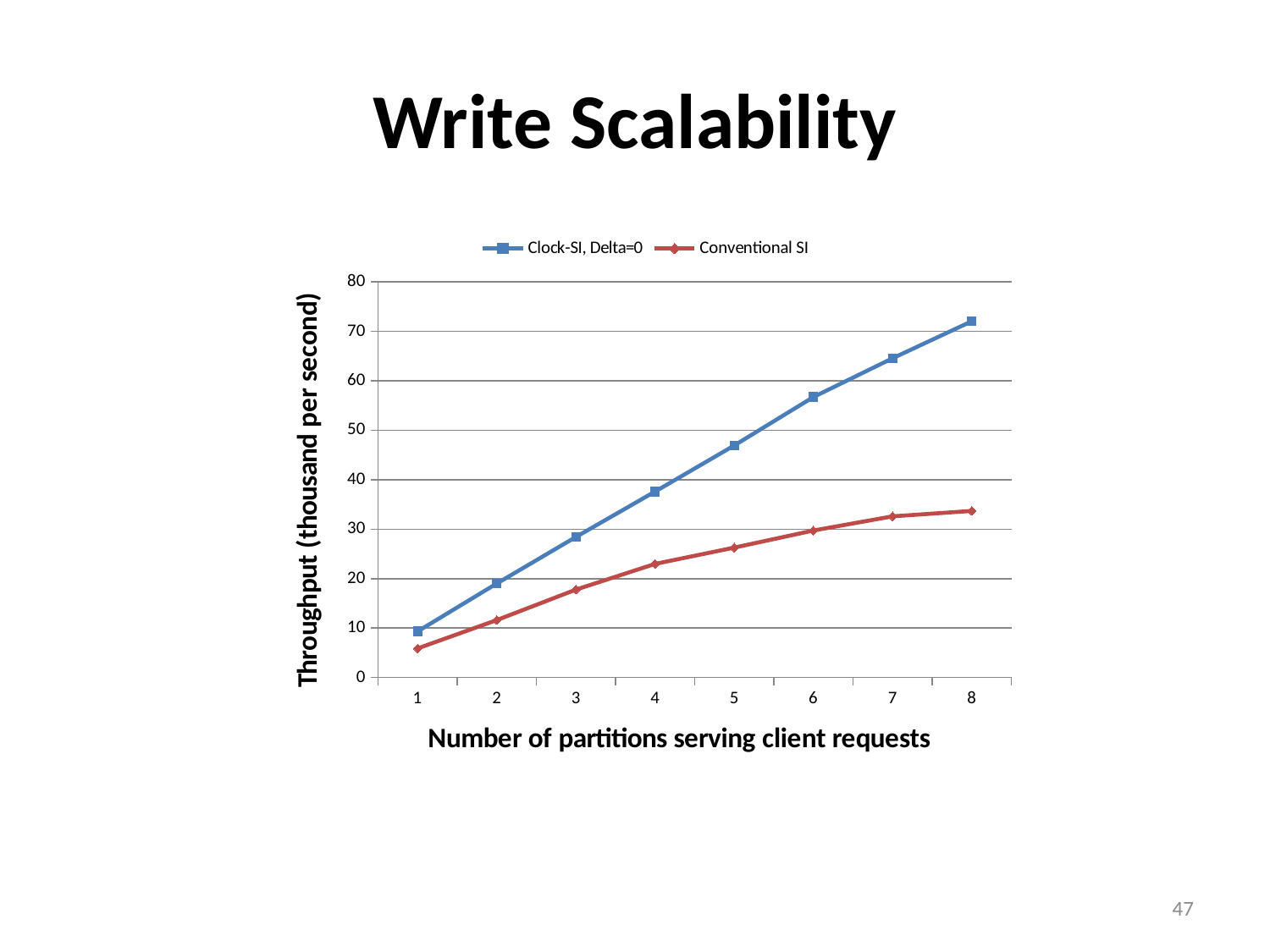
Is the throughput for Conventional SI at 8 partitions greater or less than 40? less What is the label of the y axis? Throughput (thousand per second) Is the throughput for Clock-SI, Delta=0 at 4 partitions greater or less than 30? greater At which number of partitions does Conventional SI reach its highest throughput? 8 Is the throughput for Clock-SI, Delta=0 at 8 partitions greater or less than 70? greater How many points along the x axis does each series have? 8 What is the label of the x axis? Number of partitions serving client requests Does the throughput for Clock-SI, Delta=0 rise or fall as the number of partitions increases? rise Which series has the higher throughput at 8 partitions? Clock-SI, Delta=0 How many series does the legend list? 2 What kind of chart is shown on the slide? line chart